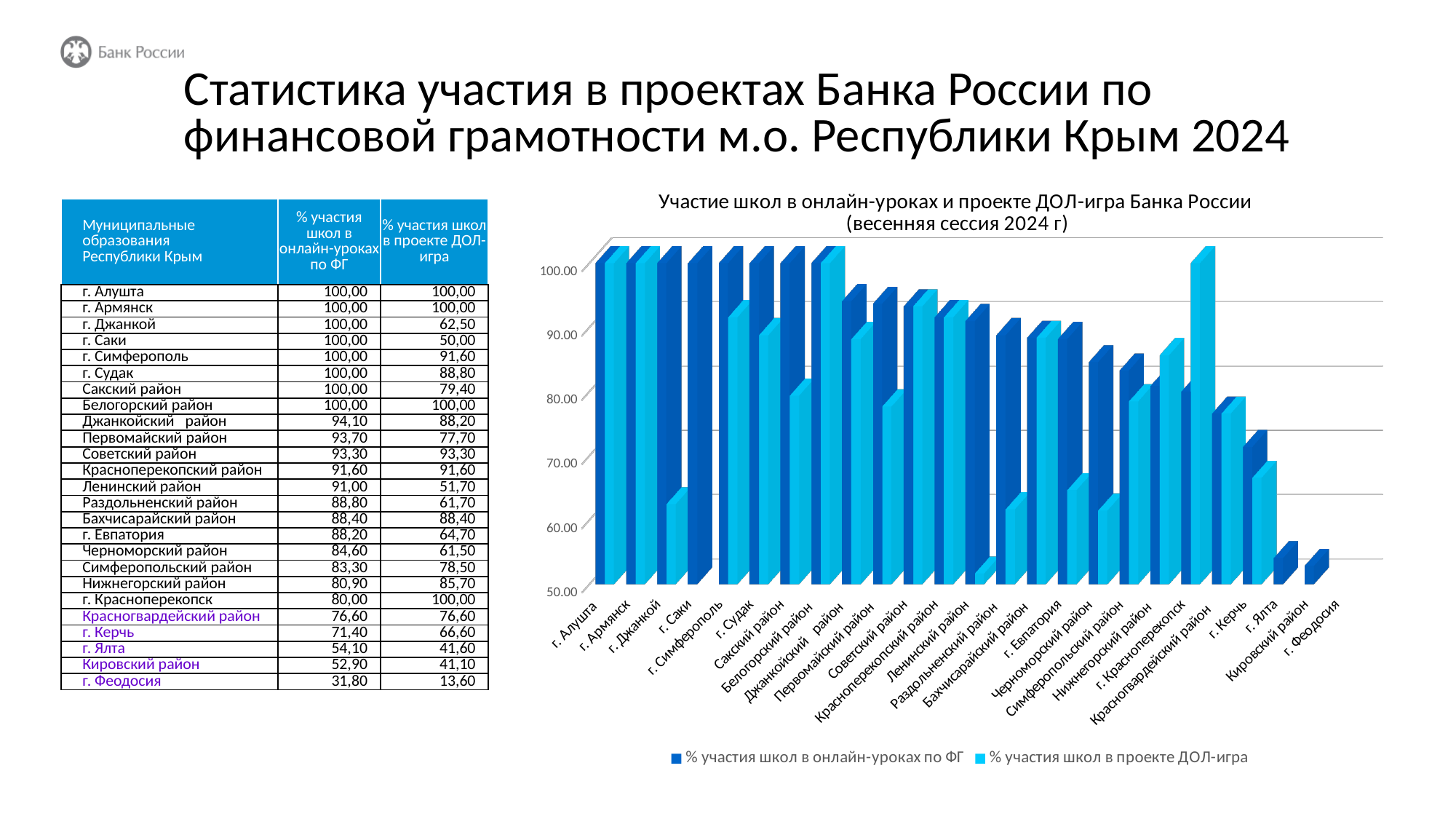
Is the value of '% участия школ в онлайн-уроках по ФГ' for г. Керчь greater or less than 60.00? greater Which municipality has the lowest value for '% участия школ в онлайн-уроках по ФГ'? г. Феодосия For г. Красноперекопск, which is larger: '% участия школ в онлайн-уроках по ФГ' or '% участия школ в проекте ДОЛ-игра'? % участия школ в проекте ДОЛ-игра What is the value of '% участия школ в проекте ДОЛ-игра' for г. Саки? 50,00 What is the value of '% участия школ в онлайн-уроках по ФГ' for г. Феодосия? 31,80 How many municipalities are plotted along the x axis of the chart? 25 What kind of chart is shown on the slide? Bar chart Do the values of '% участия школ в онлайн-уроках по ФГ' rise or fall from left to right along the x axis? Fall For г. Джанкой, what is the difference between '% участия школ в онлайн-уроках по ФГ' and '% участия школ в проекте ДОЛ-игра'? 37,50 Which series is shown in dark blue in the chart legend? % участия школ в онлайн-уроках по ФГ Is the value of '% участия школ в проекте ДОЛ-игра' for Ленинский район greater or less than 60.00? less How many series does the chart legend list? 2